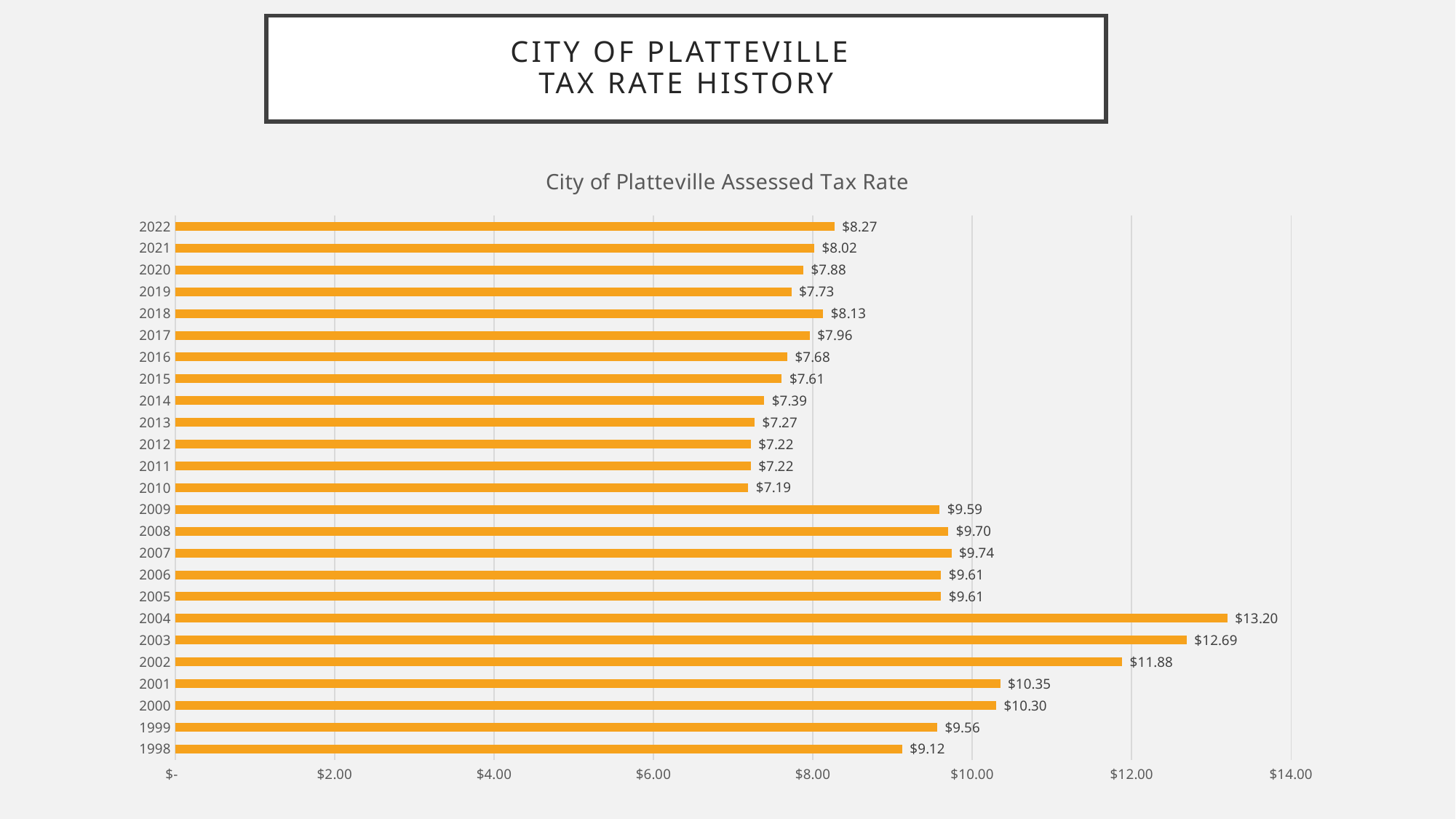
Is the tax rate for 2001 greater or less than $10.00? greater Which year has the highest assessed tax rate? 2004 Which year has a higher tax rate, 2002 or 2009? 2002 What is the difference between the tax rate in 2022 and the tax rate in 2021? $0.25 What is the assessed tax rate for 2004? $13.20 What is the assessed tax rate for 1998? $9.12 What kind of chart is shown on the slide? Bar chart How many years are shown in the chart? 25 Do the tax rates rise or fall from 2019 to 2022? Rise Which year has the lowest assessed tax rate? 2010 What is the assessed tax rate for 2022? $8.27 What is the difference between the tax rate in 2004 and the tax rate in 2003? $0.51